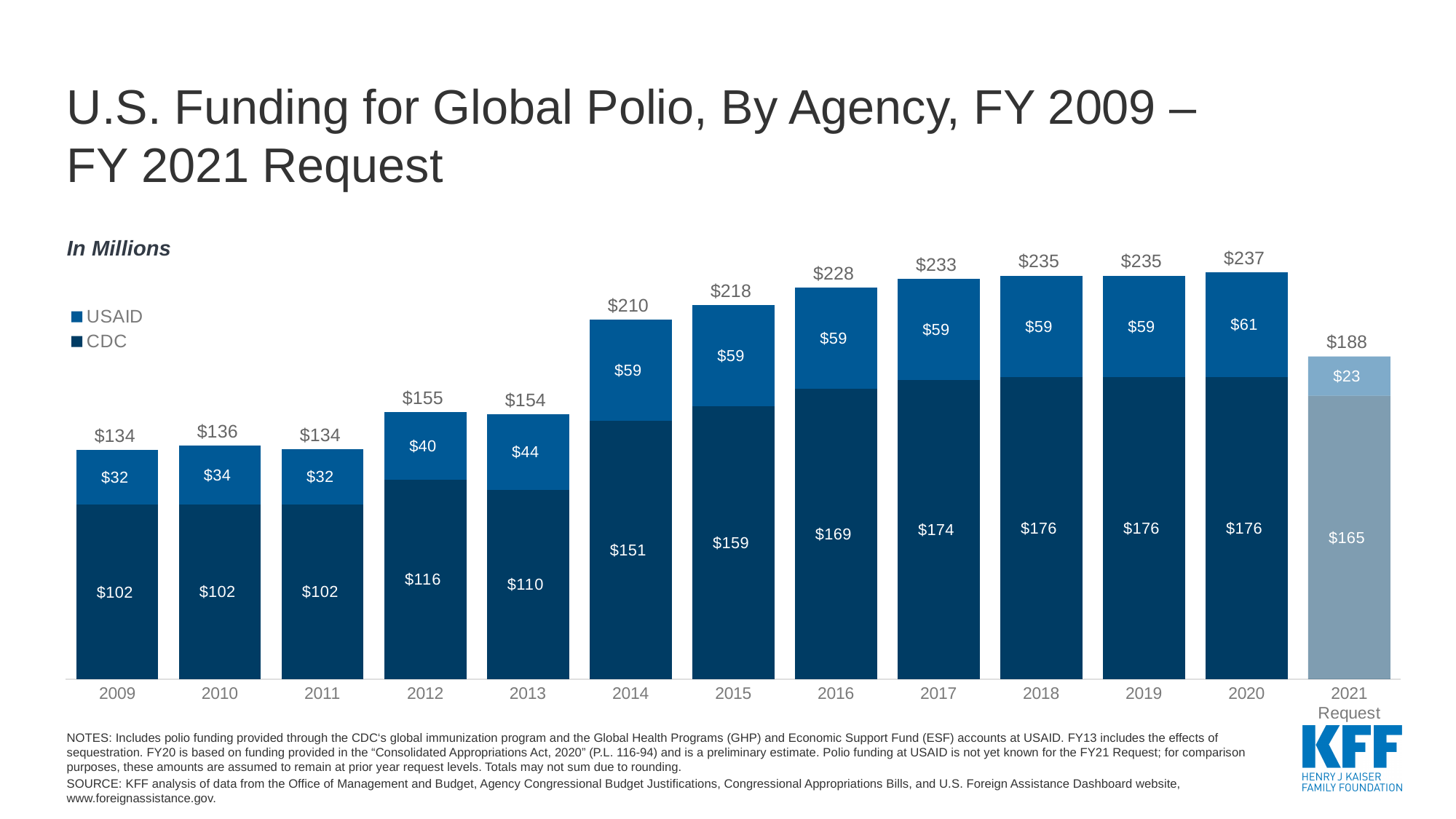
What is the difference between the CDC values for 2013 and 2012? $6 Do the total values generally rise or fall from 2009 to 2020? Rise What kind of chart is this? Stacked bar chart Is the USAID value larger in 2013 or in 2012? 2013 Which year has the lowest CDC value? 2009, 2010 and 2011 (all $102) Which year has the highest total funding? 2020 What is the USAID value for 2020? $61 How many series does the legend list? 2 What is the total funding shown for 2016? $228 What is the CDC value for 2014? $151 How many years (categories) are shown on the x axis? 13 What is the total funding shown for the 2021 Request? $188